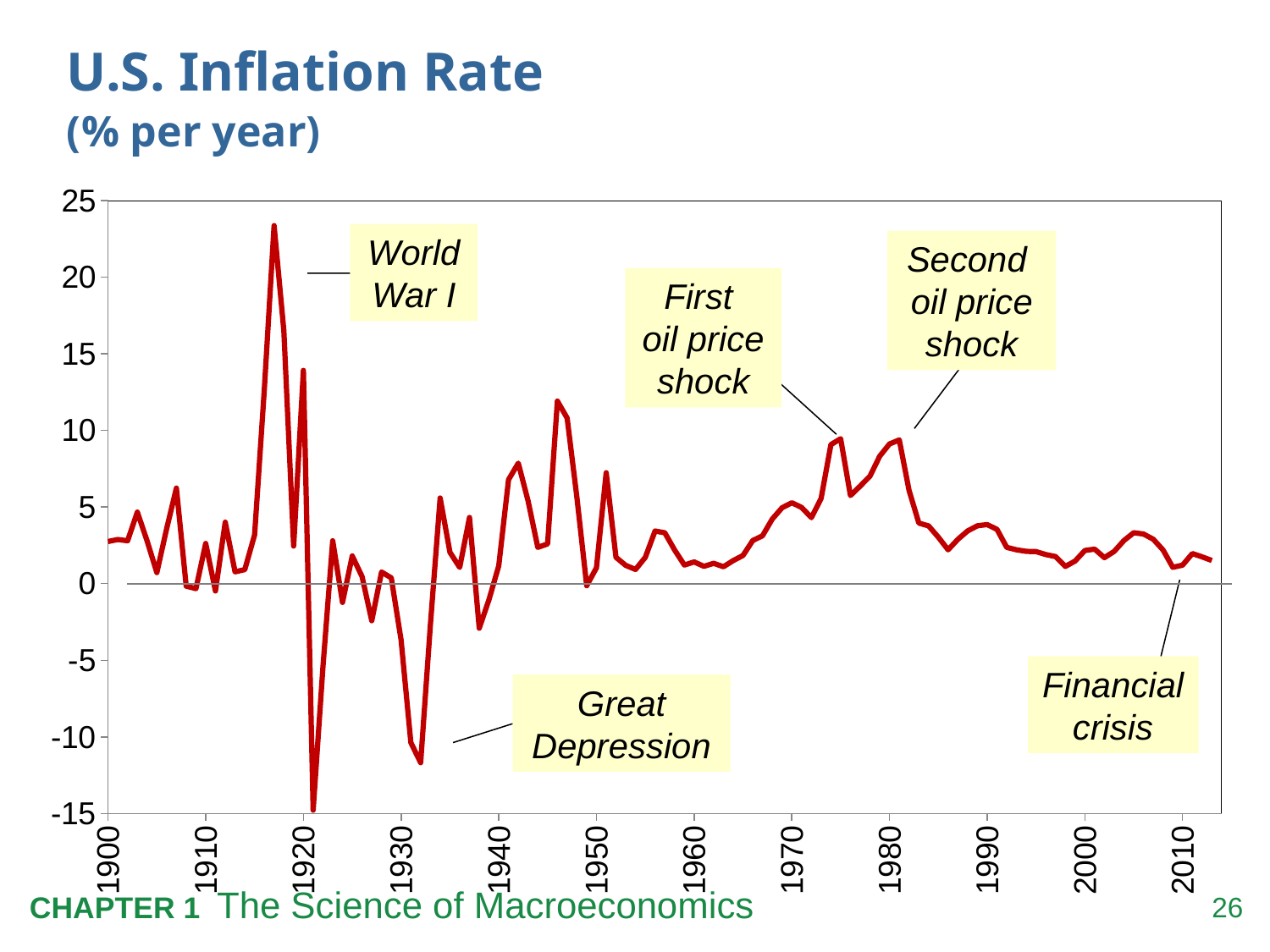
What is the title of the chart? U.S. Inflation Rate (% per year) Is the inflation rate at the point labelled Financial crisis greater or less than 5? less Between 1980 and 1990, does the inflation rate generally rise or fall? fall In which decade does the line reach its lowest value? 1920s How many annotated events are labelled on the chart? 5 Is the inflation rate at the World War I peak greater or less than 20? greater Is the inflation rate at the first oil price shock peak greater or less than 5? greater In which decade does the line reach its highest value? 1910s Which historical event is annotated at the highest peak of the line? World War I What kind of chart is shown on the slide? line chart Which is higher, the inflation peak at World War I or the peak at the first oil price shock? World War I